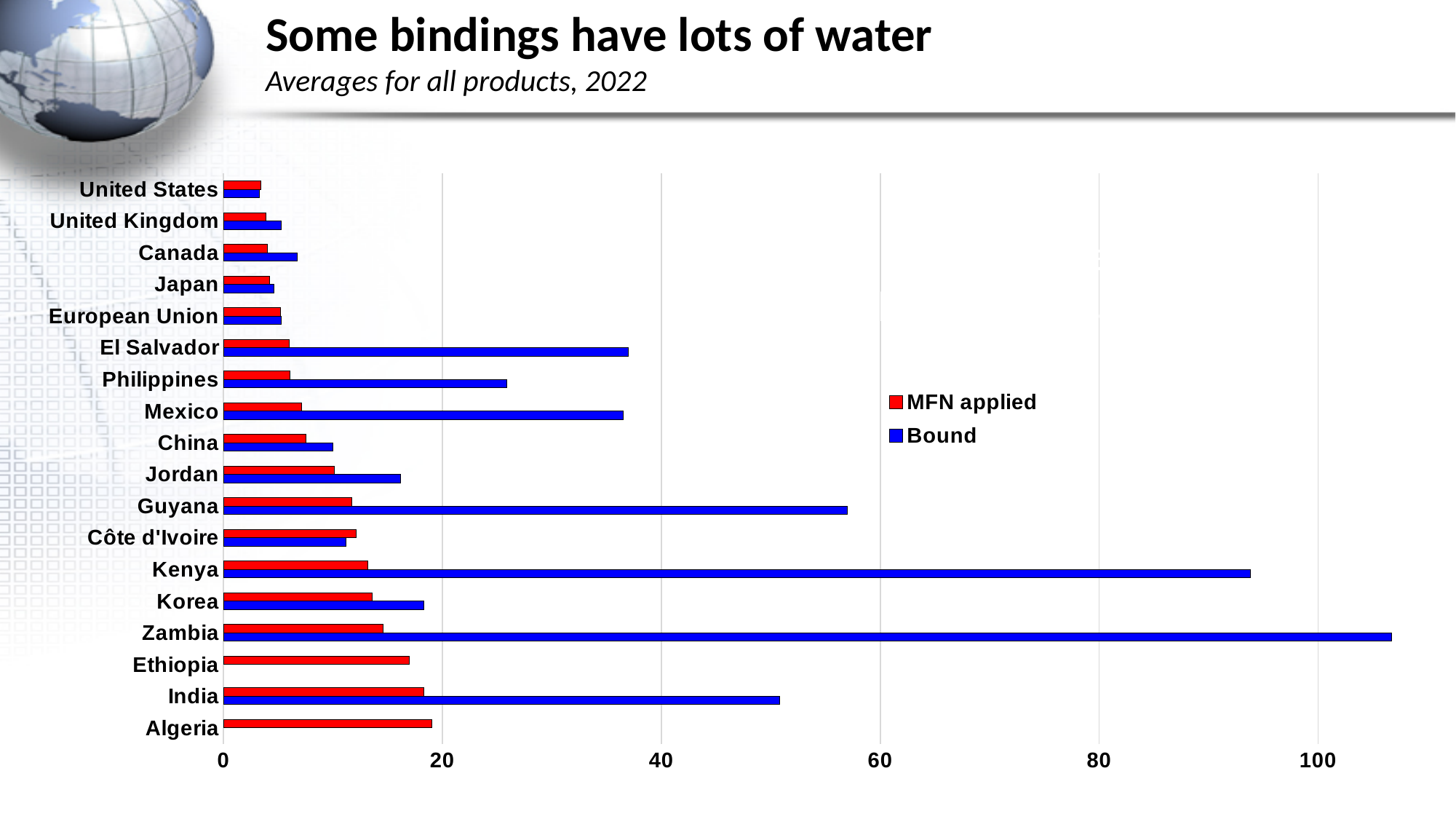
What is the subtitle of the chart? Averages for all products, 2022 Is the Bound value for Zambia greater or less than 100? greater What kind of chart is shown on the slide? bar chart Is the Bound value for Kenya greater or less than 80? greater Which series is shown in red? MFN applied Which country has the highest Bound value? Zambia How many series does the legend list? 2 Is the Bound value for Korea greater or less than 20? less Which is larger, the Bound value for Kenya or the Bound value for Guyana? Kenya How many countries or regions are listed on the vertical axis? 18